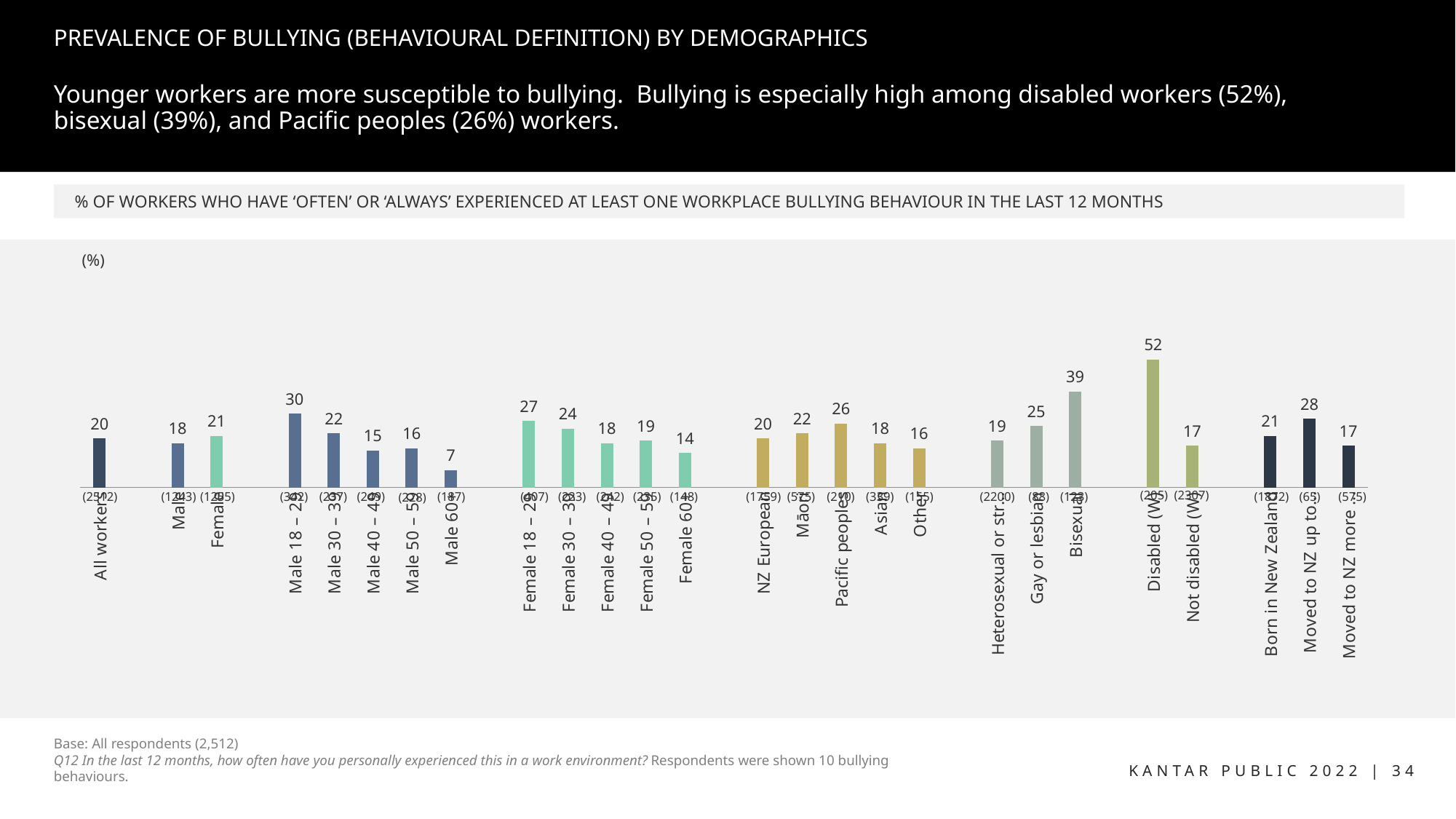
What type of chart is shown on the slide? bar chart Which is larger, the value for Female 60+ or the value for Born in New Zealand? Born in New Zealand What is the difference between the values for Gay or lesbian and Bisexual? 14 What is the value for All workers? 20 Which category has the highest value? Disabled What is the value for Pacific peoples? 26 How many bars are plotted in the chart? 26 What is the value for Bisexual? 39 Which is larger, the value for Māori or the value for Asian? Māori What is the value for Male 60+? 7 What is the difference between the values for Male and Female? 3 Which category has the lowest value? Male 60+